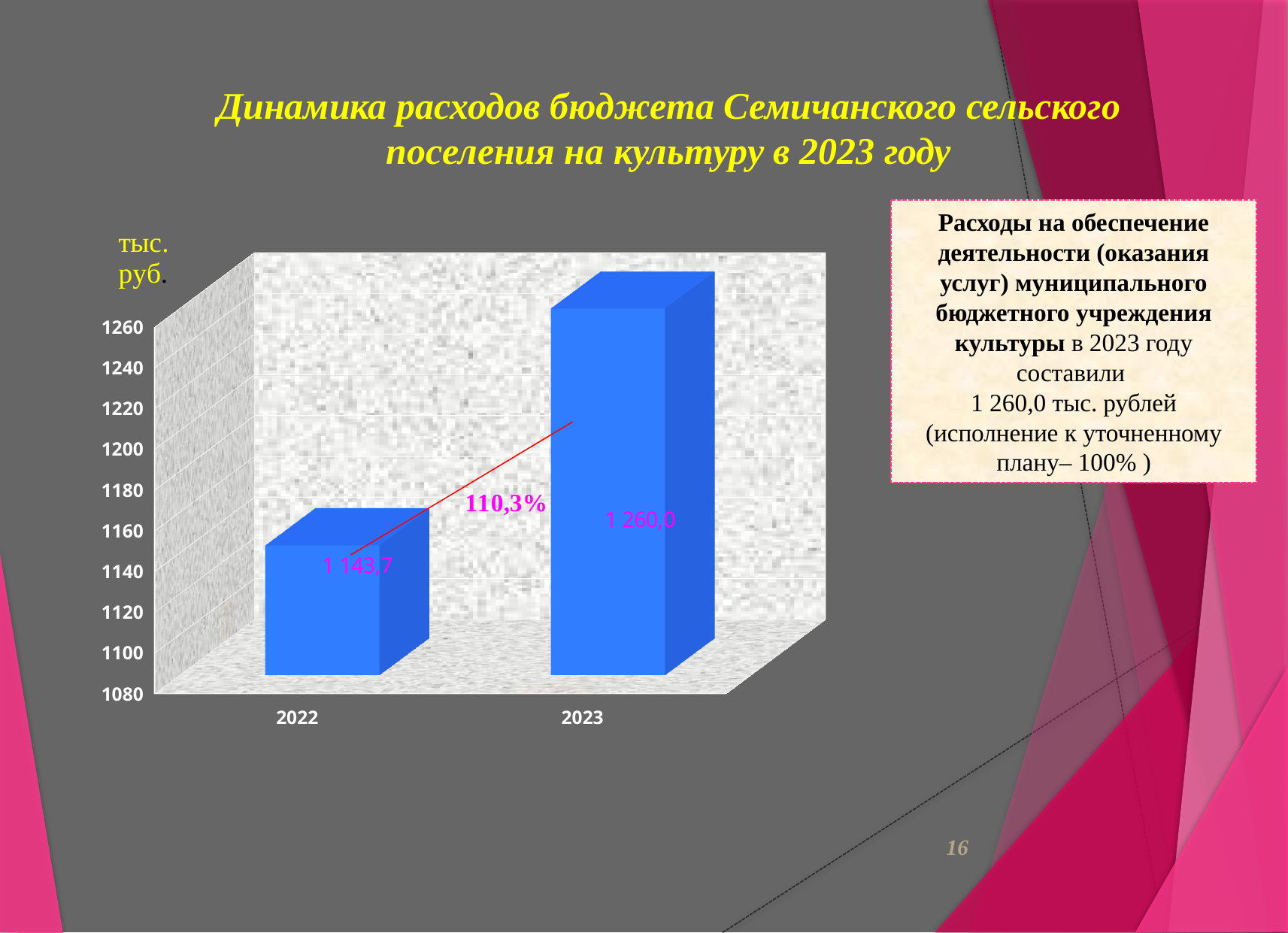
What kind of chart is shown on the slide? bar chart How many years are shown on the chart? 2 Is the value for 2023 greater or less than 1240? greater Which year has the higher value? 2023 Is the value for 2022 larger or smaller than the value for 2023? smaller Do the values rise or fall from 2022 to 2023? rise What is the value for 2023? 1 260,0 Which year has the lower value? 2022 Is the value for 2022 greater or less than 1160? less What percentage is printed next to the arrow between the two bars? 110,3% What is the value for 2022? 1 143,7 What is the difference between the 2023 and 2022 values? 116,3